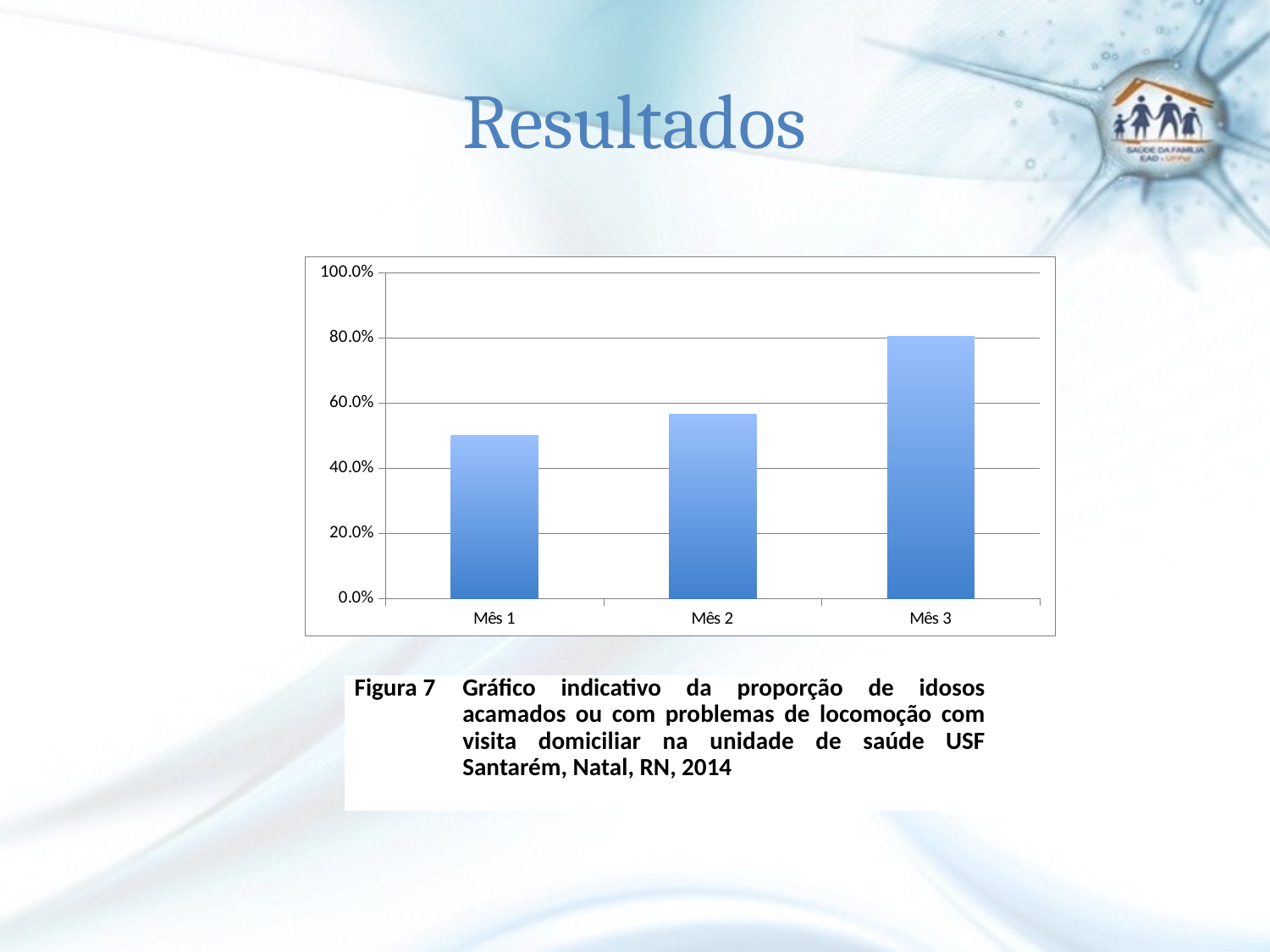
Is the value for Mês 1 greater or less than 40.0%? greater How many categories are shown on the x axis of the chart? 3 What is the figure number given in the caption below the chart? Figura 7 Do the values rise or fall from Mês 1 to Mês 3? rise Which is larger, the value for Mês 2 or the value for Mês 3? Mês 3 Which is larger, the value for Mês 1 or the value for Mês 2? Mês 2 Is the value for Mês 3 greater or less than 60.0%? greater What kind of chart is shown on the slide? bar chart Is the value for Mês 2 greater or less than 40.0%? greater Which category has the highest value in the chart? Mês 3 Which category has the lowest value in the chart? Mês 1